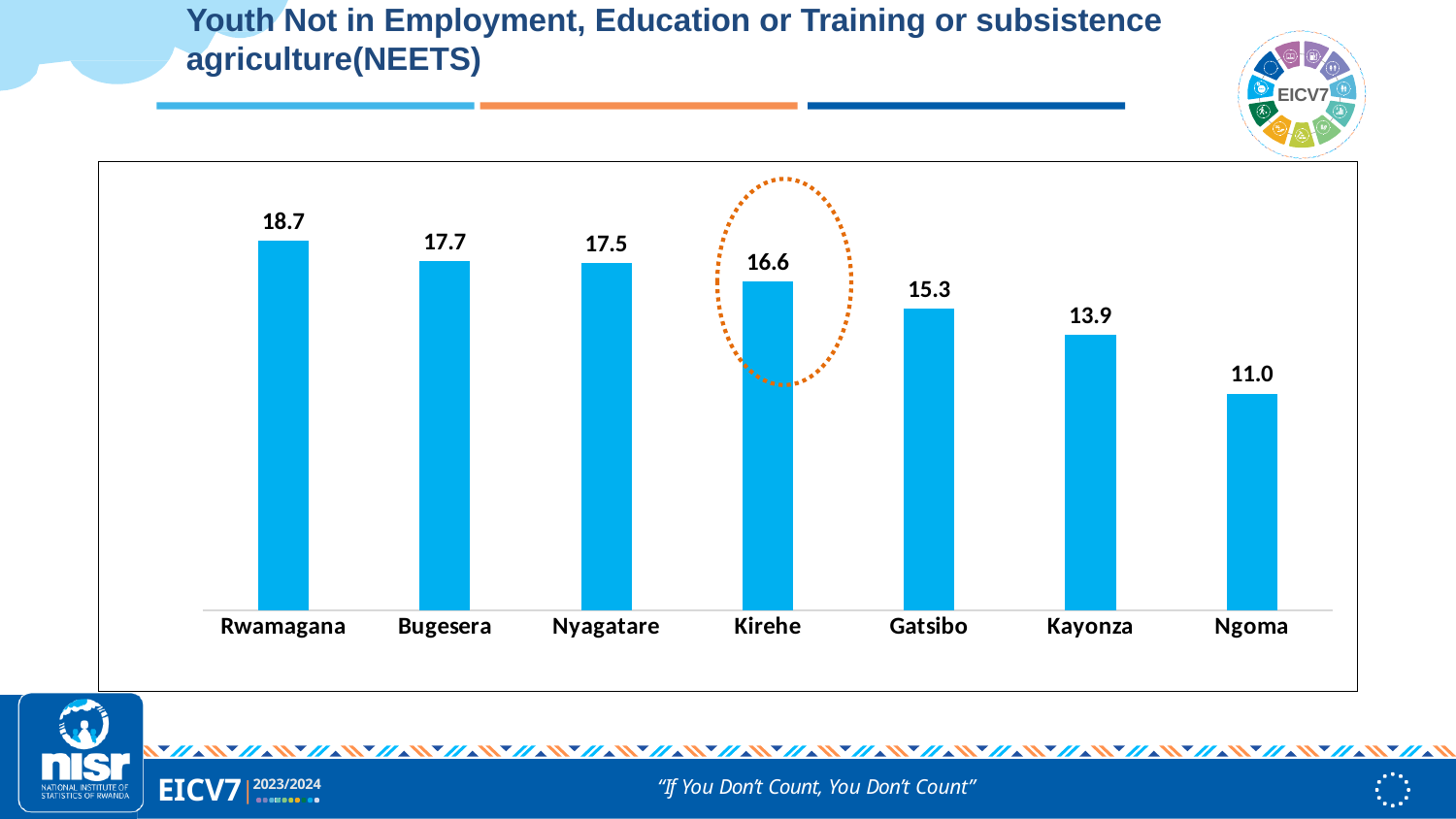
What is the value for Rwamagana? 18.7 Which district has the lowest value? Ngoma What is the difference between the values for Rwamagana and Ngoma? 7.7 How many districts are shown on the chart? 7 What is the difference between the values for Gatsibo and Kayonza? 1.4 What is the value for Kayonza? 13.9 Which is larger, the value for Bugesera or the value for Gatsibo? Bugesera What is the value for Ngoma? 11.0 What kind of chart is shown on the slide? Bar chart Which district's bar is highlighted with a dotted orange circle? Kirehe Which district has the highest value? Rwamagana What is the value for Kirehe? 16.6